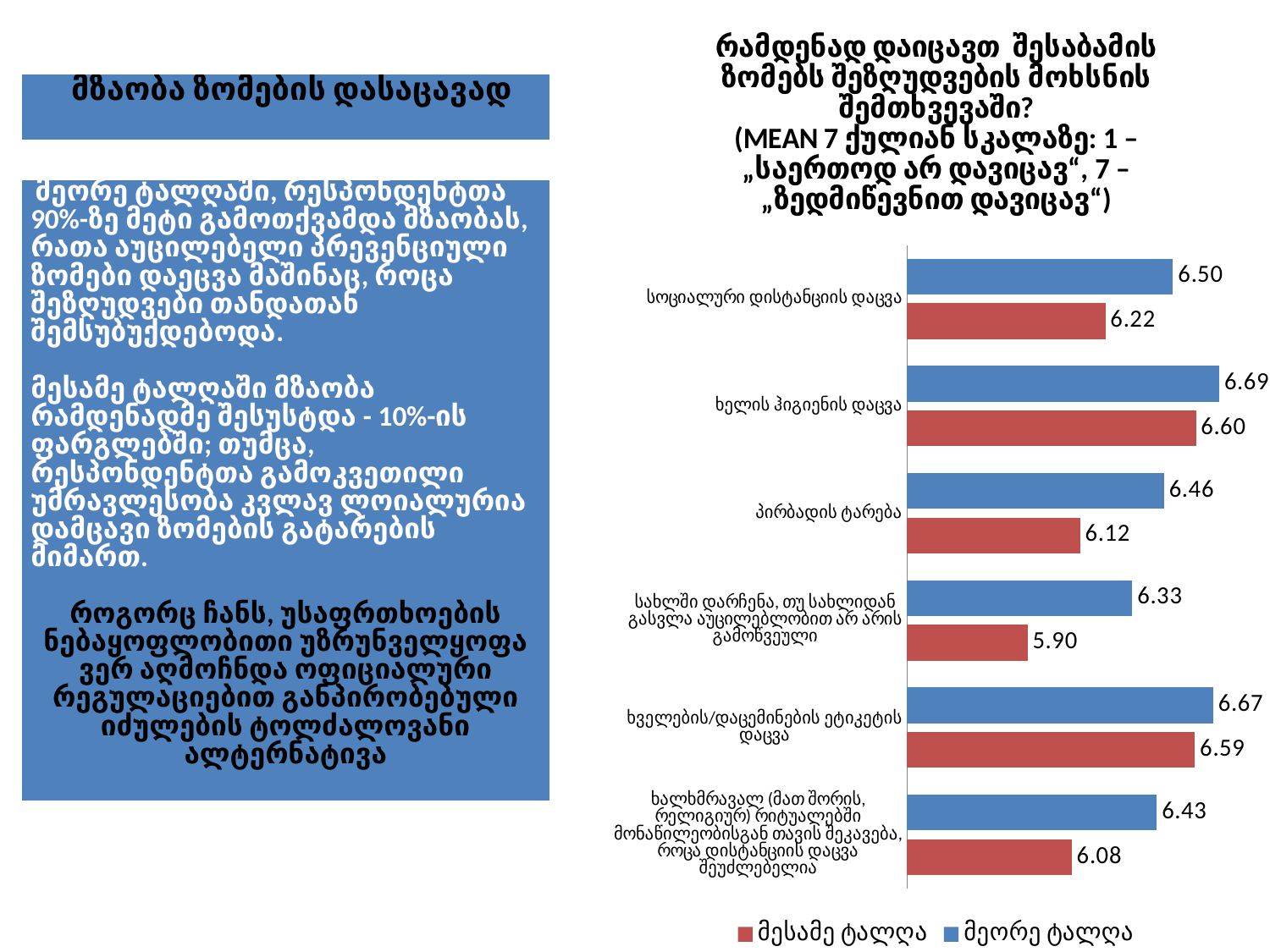
Which series is shown in red in the legend? მესამე ტალღა What is the difference between the "მეორე ტალღა" and "მესამე ტალღა" values for "სახლში დარჩენა, თუ სახლიდან გასვლა აუცილებლობით არ არის გამოწვეული"? 0.43 How many series does the legend list? 2 Which is larger for "ხველების/დაცემინების ეტიკეტის დაცვა": the "მეორე ტალღა" value or the "მესამე ტალღა" value? მეორე ტალღა What is the value for "მეორე ტალღა" for "სოციალური დისტანციის დაცვა"? 6.50 Which category has the highest value for "მეორე ტალღა"? ხელის ჰიგიენის დაცვა What is the value for "მესამე ტალღა" for "პირბადის ტარება"? 6.12 What is the difference between the "მეორე ტალღა" and "მესამე ტალღა" values for "სოციალური დისტანციის დაცვა"? 0.28 What is the value for "მესამე ტალღა" for "ხელის ჰიგიენის დაცვა"? 6.60 How many categories are shown on the chart? 6 Which category has the lowest value for "მესამე ტალღა"? სახლში დარჩენა, თუ სახლიდან გასვლა აუცილებლობით არ არის გამოწვეული What kind of chart is shown on the slide? Bar chart